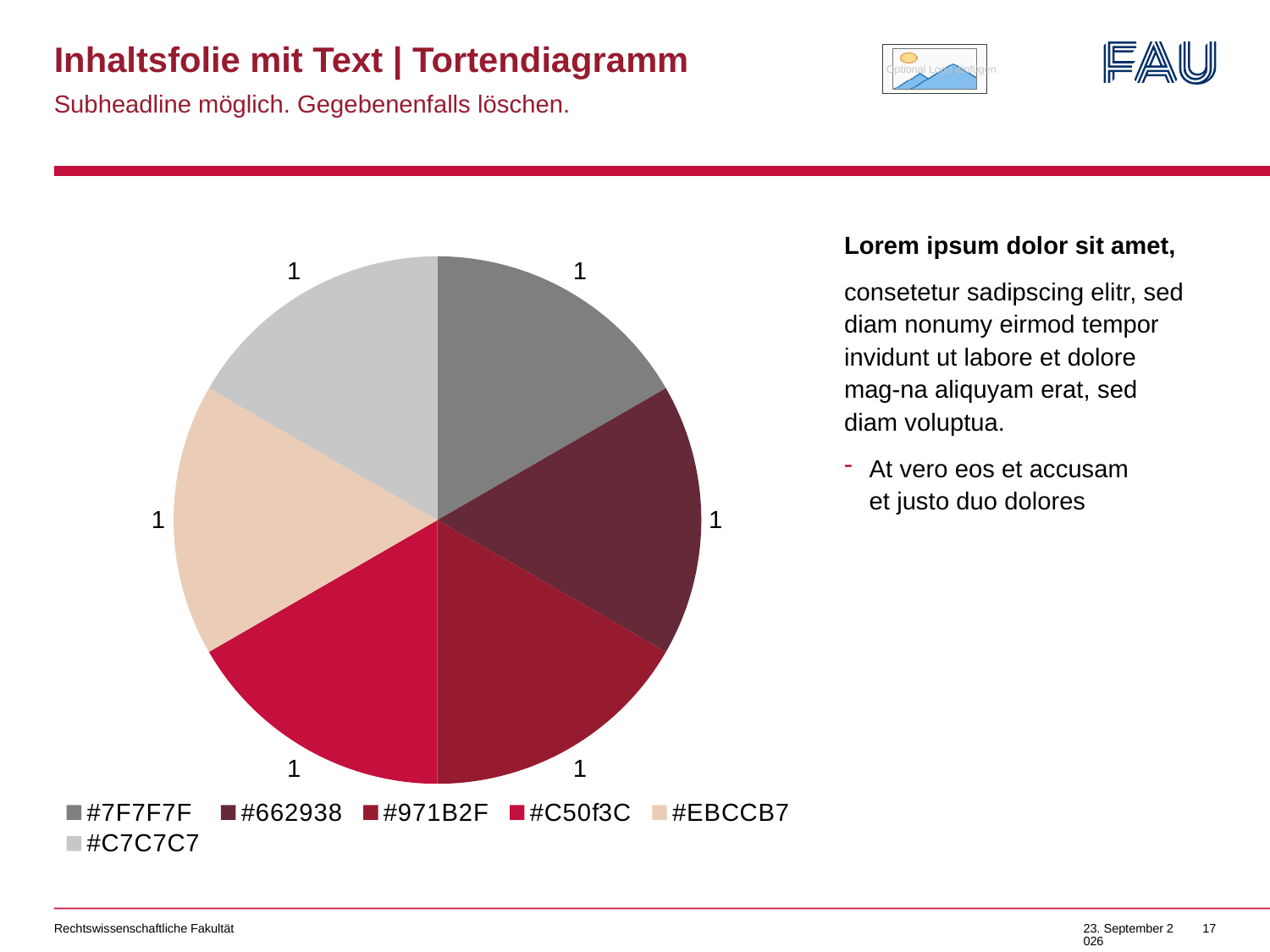
What is the value shown for the #C50f3C slice of the pie chart? 1 What is the difference between the values of the #662938 and #971B2F slices? 0 What is the value shown for the #EBCCB7 slice of the pie chart? 1 What kind of chart is shown on the slide? pie chart What share of the pie does the #C7C7C7 slice represent? 1/6 Which is larger, the value for #7F7F7F or the value for #C7C7C7? they are equal How many entries does the legend of the pie chart list? 6 Which legend entry is listed first in the pie chart's legend? #7F7F7F What is the total of all the slice values in the pie chart? 6 Which legend entry is listed last in the pie chart's legend? #C7C7C7 What is the value shown for the #7F7F7F slice of the pie chart? 1 How many slices does the pie chart have? 6